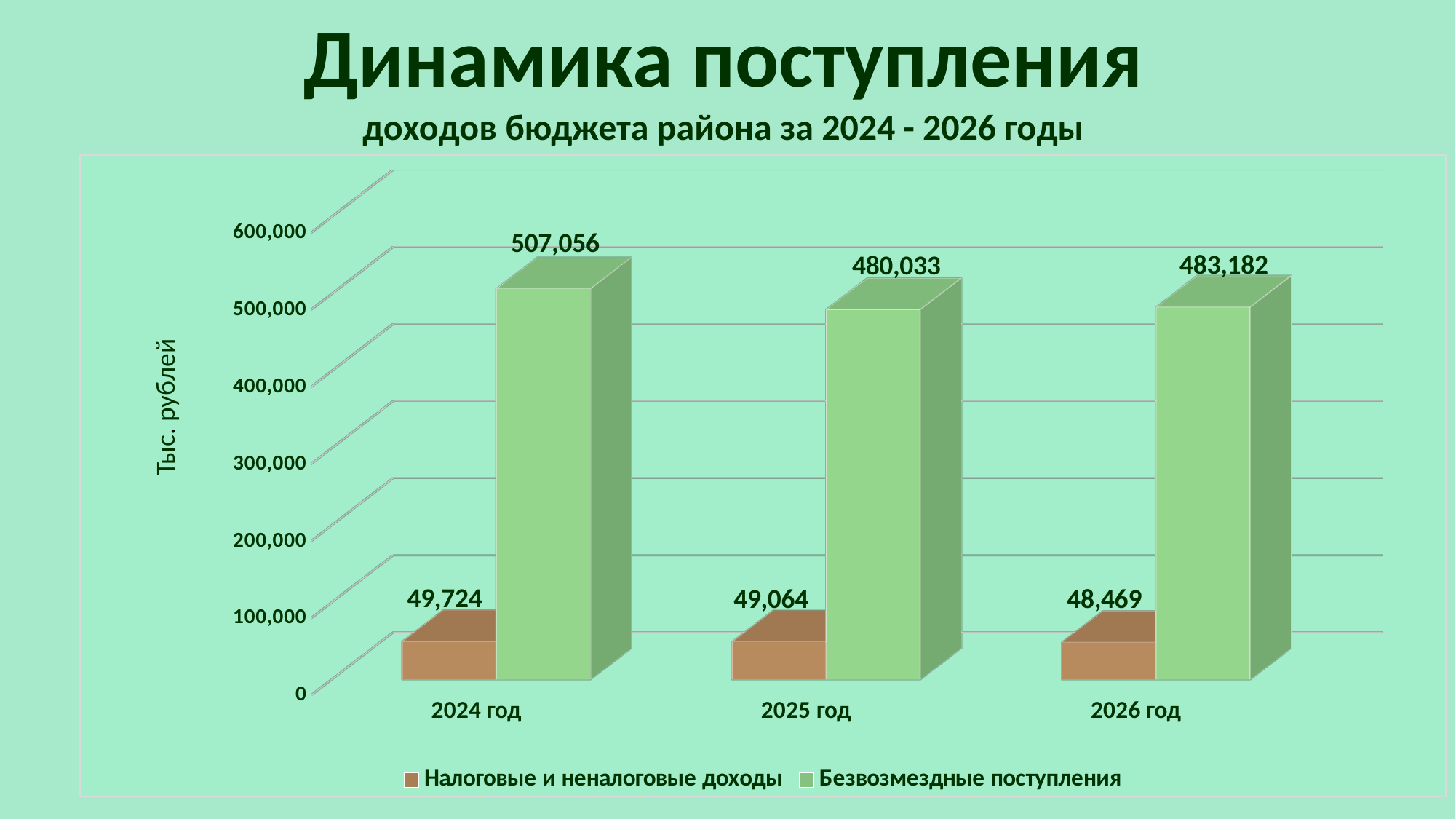
What is the value for Безвозмездные поступления in 2024 год? 507,056 Is the value for Налоговые и неналоговые доходы in 2025 год greater or less than 100,000? less What is the difference between Налоговые и неналоговые доходы in 2024 год and 2025 год? 660 In which year is Безвозмездные поступления highest? 2024 год How many years are shown on the x axis? 3 Which is larger: Безвозмездные поступления in 2025 год or in 2026 год? 2026 год How many series does the legend list? 2 What is the value for Безвозмездные поступления in 2025 год? 480,033 What is the difference between Безвозмездные поступления in 2024 год and 2025 год? 27,023 In which year is Налоговые и неналоговые доходы lowest? 2026 год Do the values for Налоговые и неналоговые доходы rise or fall from 2024 год to 2026 год? fall What is the value for Налоговые и неналоговые доходы in 2026 год? 48,469